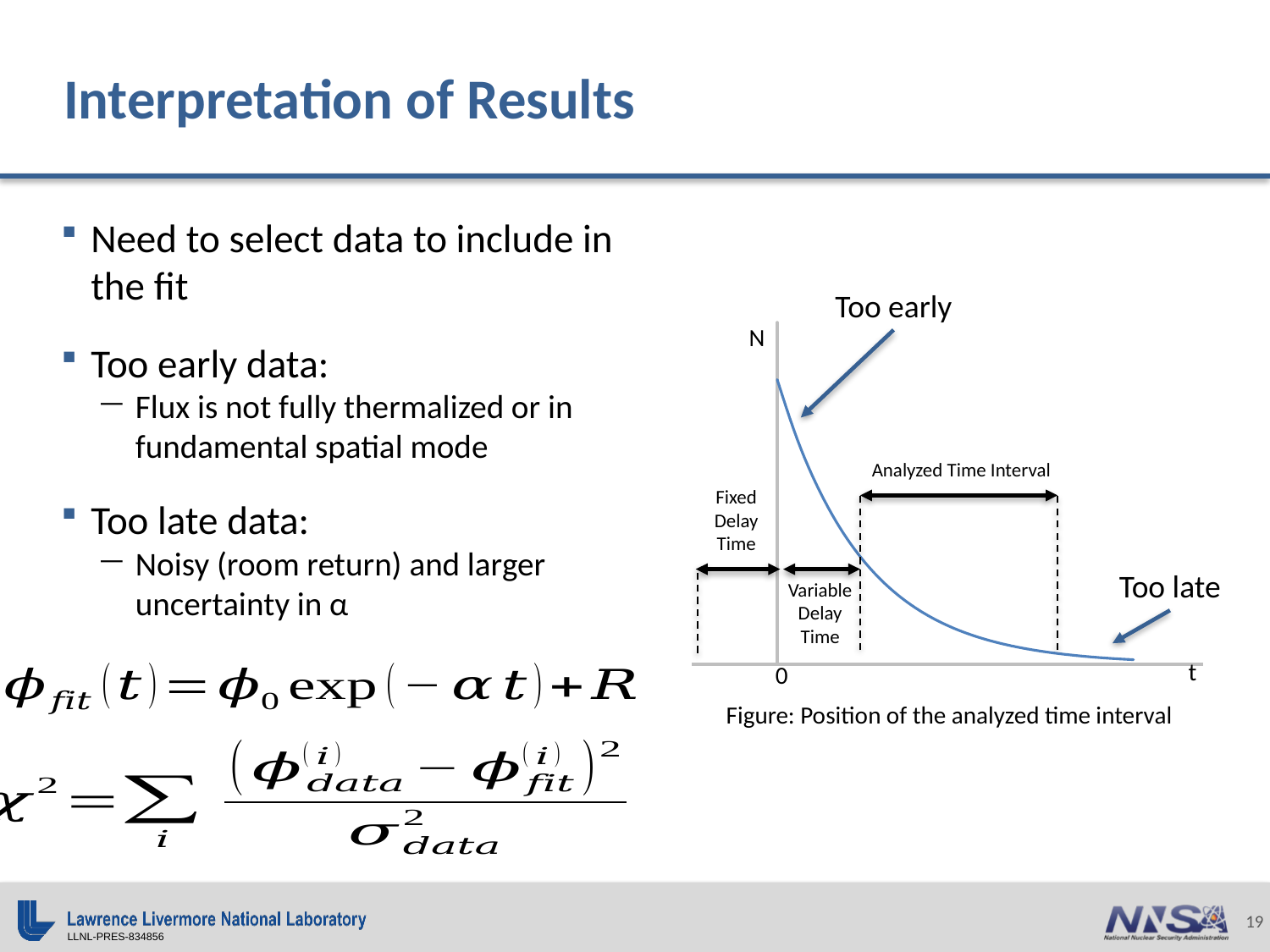
What is the caption of the figure on the right of the slide? Figure: Position of the analyzed time interval What label is on the vertical axis of the figure on the right? N In the figure on the right, does the plotted curve rise or fall as t increases? fall What kind of chart is shown in the figure on the right of the slide? line chart